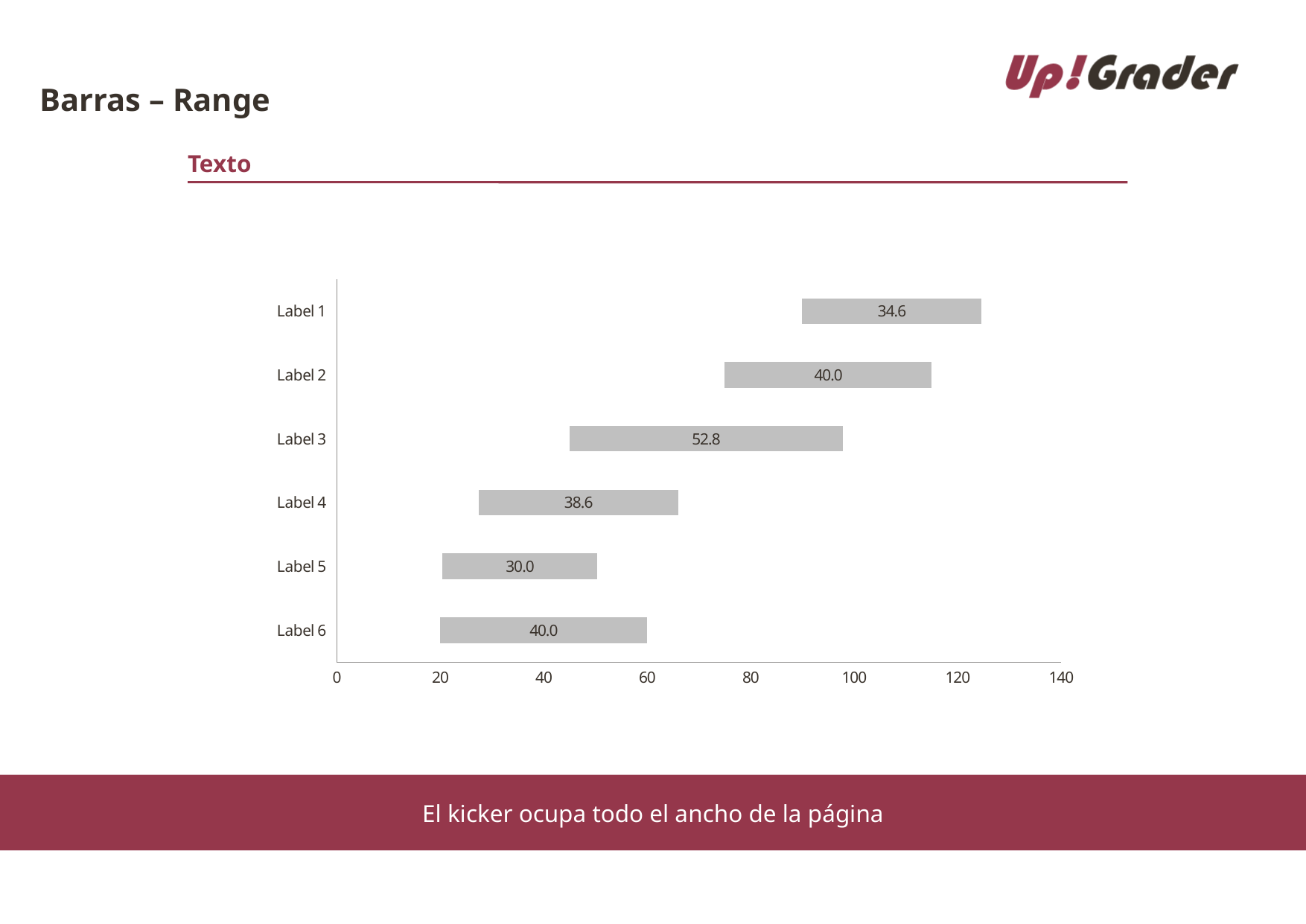
Which category has the largest labelled value? Label 3 Which has the larger labelled value, Label 2 or Label 4? Label 2 Does the bar for Label 5 end at a value greater or less than 60 on the axis? less What is the difference between the labelled values of Label 3 and Label 5? 22.8 What is the data label shown on the bar for Label 3? 52.8 Which category has the smallest labelled value? Label 5 What is the data label shown on the bar for Label 1? 34.6 What is the data label shown on the bar for Label 4? 38.6 What is the data label shown on the bar for Label 5? 30.0 What kind of chart is shown on the slide? Bar chart How many categories are shown on the chart? 6 Does the bar for Label 1 start at a value greater or less than 80 on the axis? greater